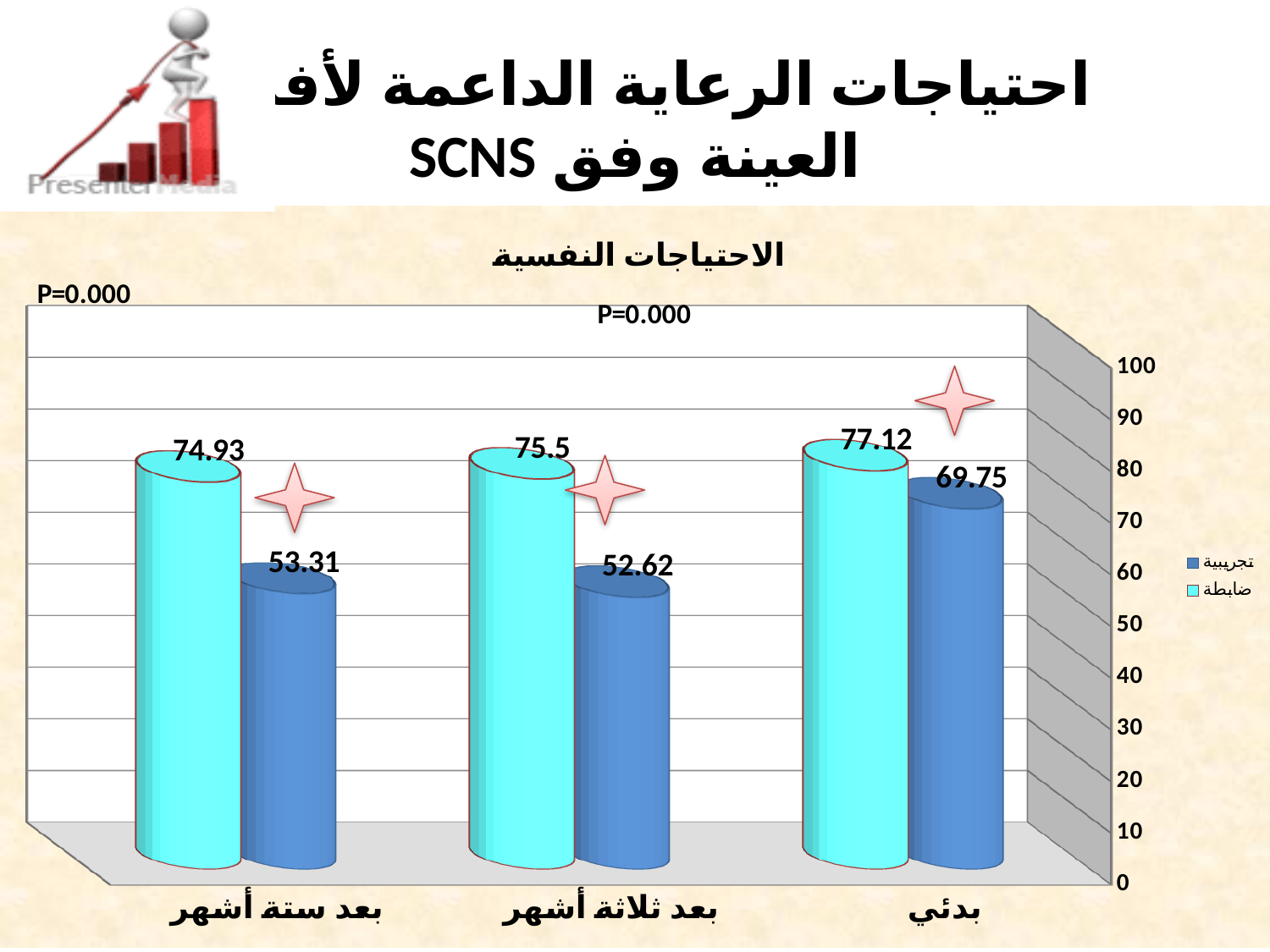
At which category is the تجريبية series lowest? بعد ثلاثة أشهر What kind of chart is shown on the slide? Bar chart What is the value for the ضابطة series at بعد ثلاثة أشهر? 75.5 What is the value for the ضابطة series at بدئي? 77.12 At which category is the تجريبية series highest? بدئي How many series does the legend list? 2 How many categories are shown on the x axis? 3 What is the value for the تجريبية series at بعد ستة أشهر? 53.31 Which is larger at بعد ستة أشهر: the ضابطة value or the تجريبية value? ضابطة What is the value for the تجريبية series at بعد ثلاثة أشهر? 52.62 What is the title of the chart? الاحتياجات النفسية What is the difference between the ضابطة and تجريبية values at بدئي? 7.37